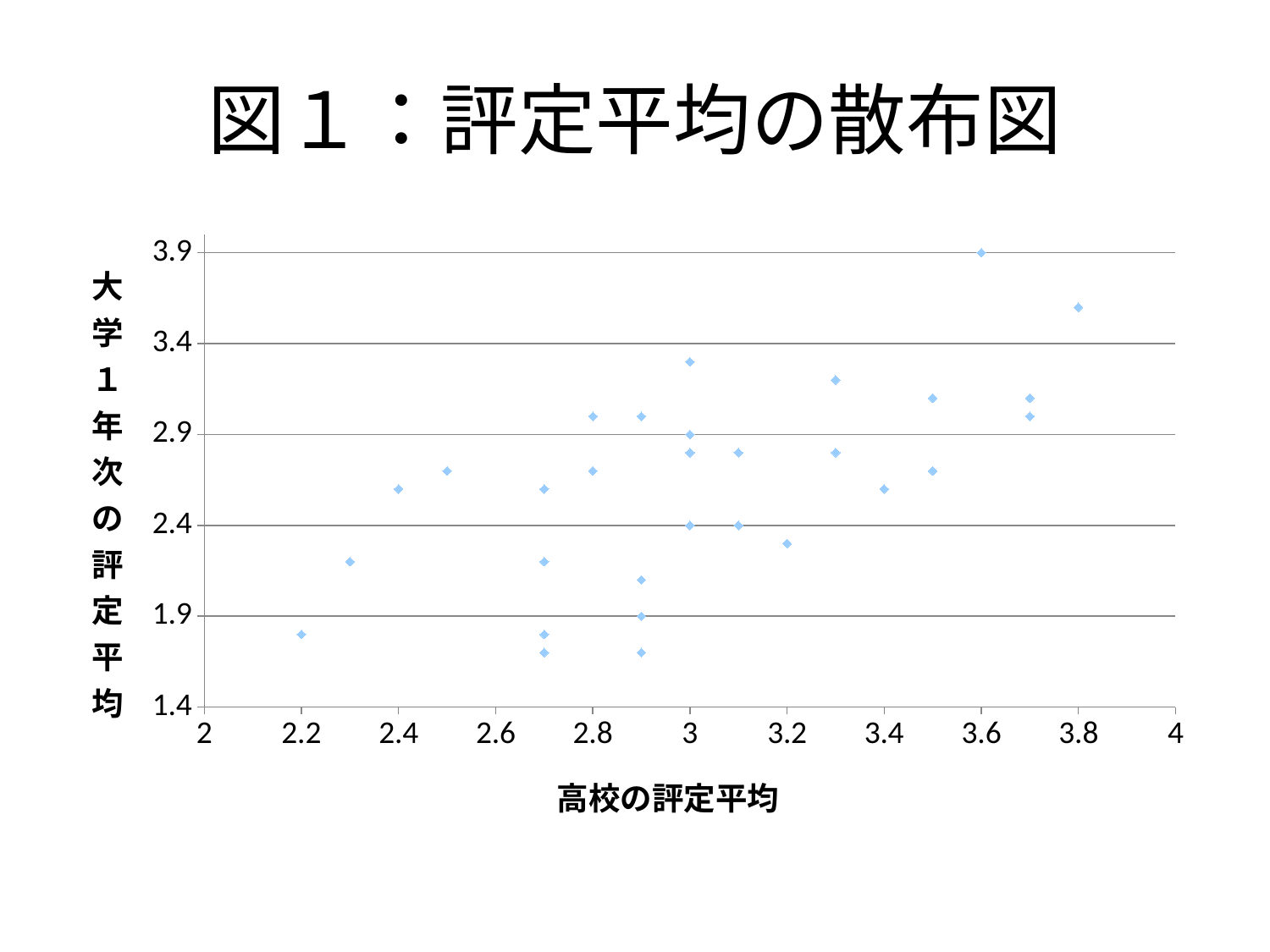
Is the 大学１年次の評定平均 value of the point at 高校の評定平均 3.8 greater or less than 3.4? greater What is the label of the x axis? 高校の評定平均 What kind of chart is shown on the slide? scatter plot Which has the higher 大学１年次の評定平均: the point at 高校の評定平均 3.6 or the point at 3.8? 3.6 At which 高校の評定平均 value is the highest 大学１年次の評定平均 point located? 3.6 Is the 大学１年次の評定平均 value of the point at 高校の評定平均 2.2 greater or less than 2.4? less What is the lowest value shown on the y axis? 1.4 What is the smallest 高校の評定平均 value at which a point is plotted? 2.2 Overall, do the 大学１年次の評定平均 values tend to rise or fall as 高校の評定平均 increases? rise What is the largest 高校の評定平均 value at which a point is plotted? 3.8 What is the 大学１年次の評定平均 value of the highest point, at 高校の評定平均 3.6? 3.9 What is the title of the chart? 図１：評定平均の散布図